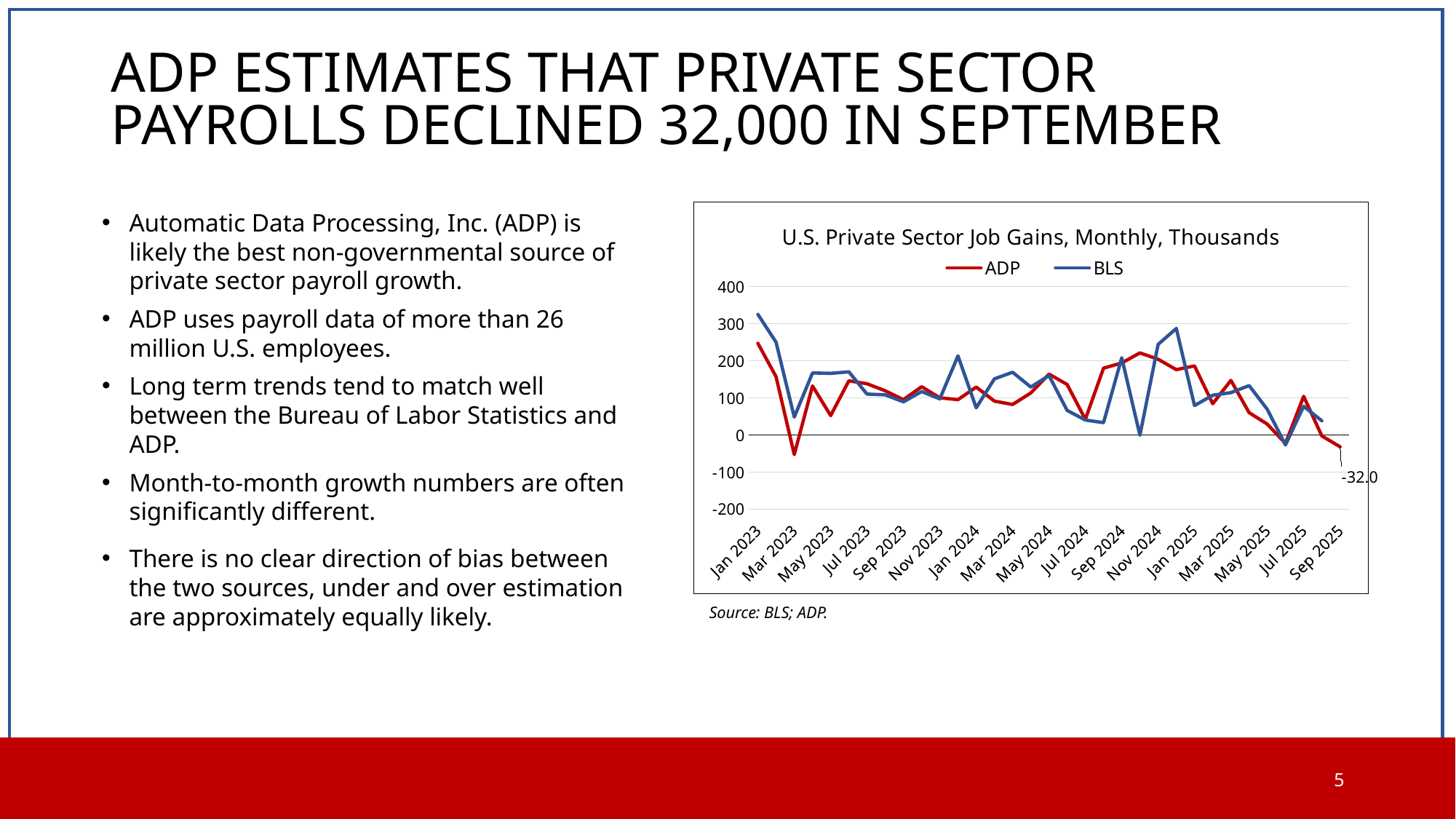
Is the ADP value for Mar 2023 greater or less than 0? less Is the BLS value for Jan 2023 greater or less than 300? greater In Jan 2023, which series has the higher value, ADP or BLS? BLS Overall, does the ADP series rise or fall from Jan 2023 to Sep 2025? fall Is the ADP value for Jan 2023 greater or less than 200? greater What are the two series named in the chart's legend? ADP and BLS What is the title of the chart? U.S. Private Sector Job Gains, Monthly, Thousands What is the ADP value for Sep 2025? -32.0 What kind of chart is shown on the slide? line chart How many series does the chart's legend list? 2